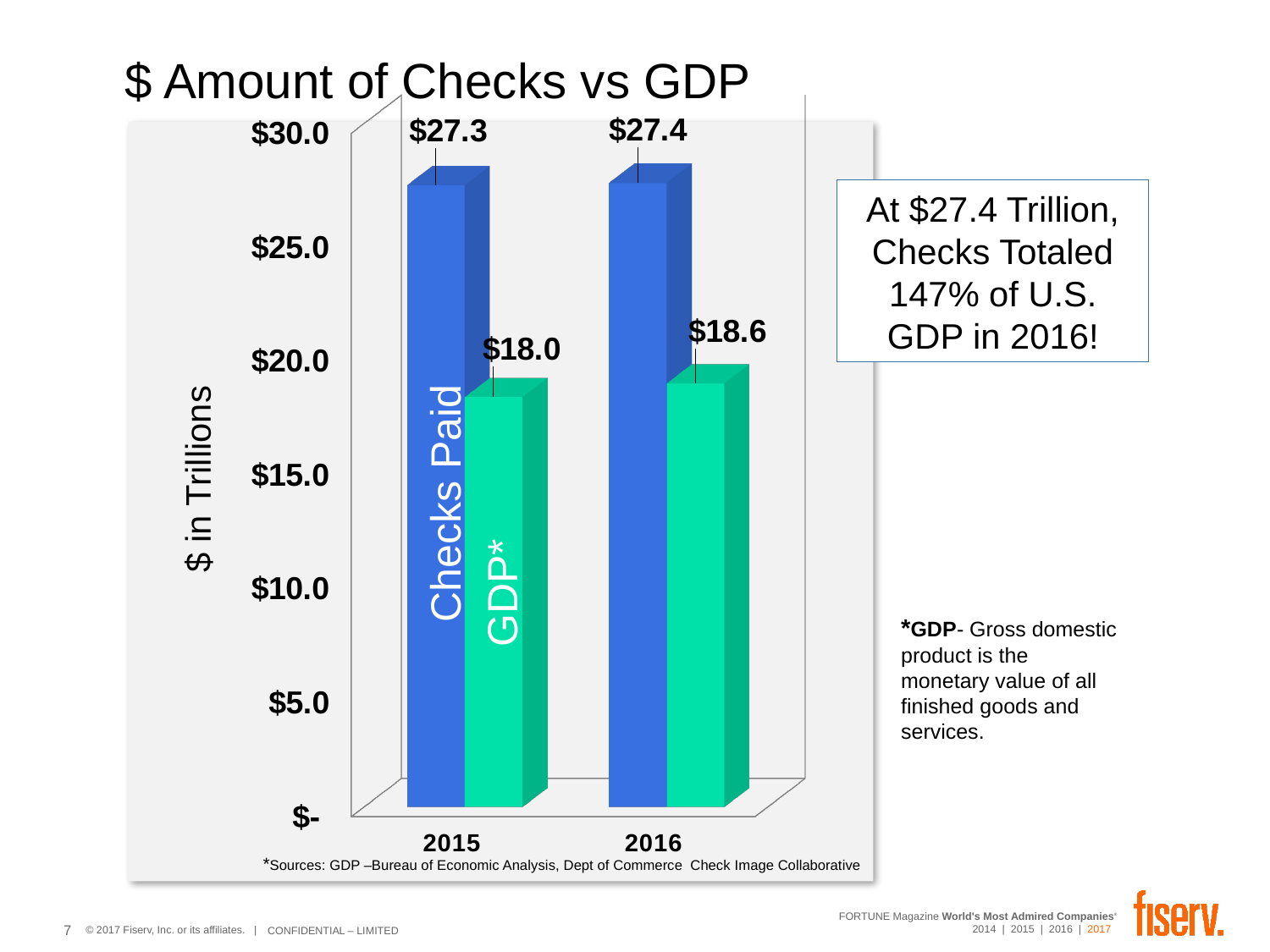
How many years are shown on the x axis? 2 Is the value for GDP in 2015 greater or less than $20.0? less What was the value of GDP in 2016? $18.6 Which year had the higher value for Checks Paid? 2016 What is the difference between GDP in 2016 and GDP in 2015? $0.6 What was the value of GDP in 2015? $18.0 Which is larger in 2015, Checks Paid or GDP? Checks Paid What is the title of the chart? $ Amount of Checks vs GDP What kind of chart is shown on the slide? Bar chart What was the value of Checks Paid in 2016? $27.4 What was the value of Checks Paid in 2015? $27.3 What is the difference between Checks Paid and GDP in 2016? $8.8